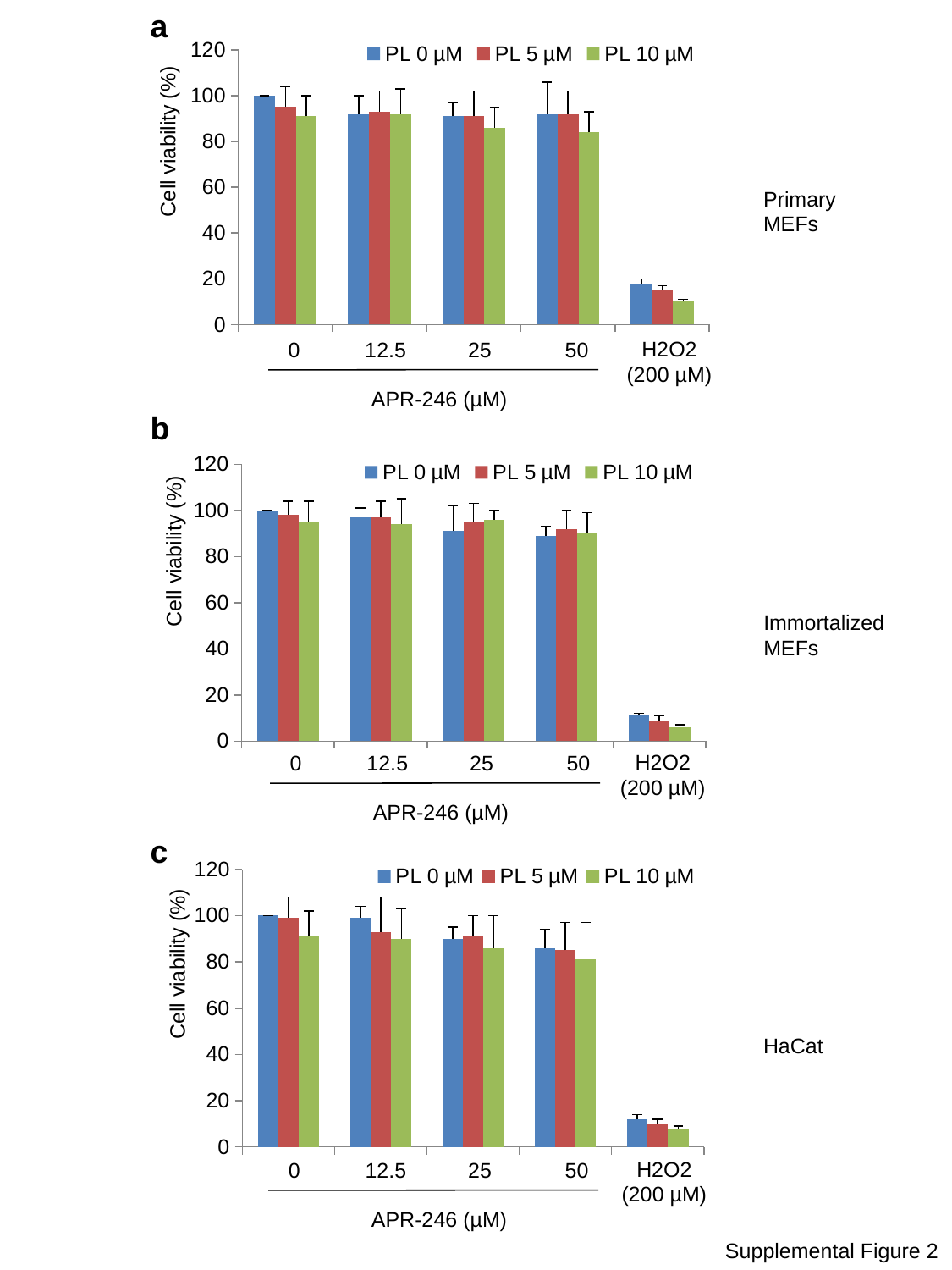
In chart a (Primary MEFs), is the PL 10 µM value for H2O2 (200 µM) greater or less than 20? less In chart b (Immortalized MEFs), which is larger: the PL 0 µM value at APR-246 0 µM or the PL 0 µM value at H2O2 (200 µM)? APR-246 0 µM In chart a (Primary MEFs), how many categories are shown on the x axis? 5 In chart a (Primary MEFs), which category has the lowest PL 0 µM value? H2O2 (200 µM) In chart c (HaCat), is the PL 5 µM value for H2O2 (200 µM) greater or less than 20? less What kind of chart is chart a (Primary MEFs)? bar chart In chart a (Primary MEFs), how many series does the legend list? 3 What is the y-axis label of chart c (HaCat)? Cell viability (%) In chart c (HaCat), how many series does the legend list? 3 In chart b (Immortalized MEFs), how many categories are shown on the x axis? 5 In chart c (HaCat), which category has the lowest PL 10 µM value? H2O2 (200 µM) In chart b (Immortalized MEFs), is the PL 0 µM value for APR-246 at 0 µM greater or less than 80? greater